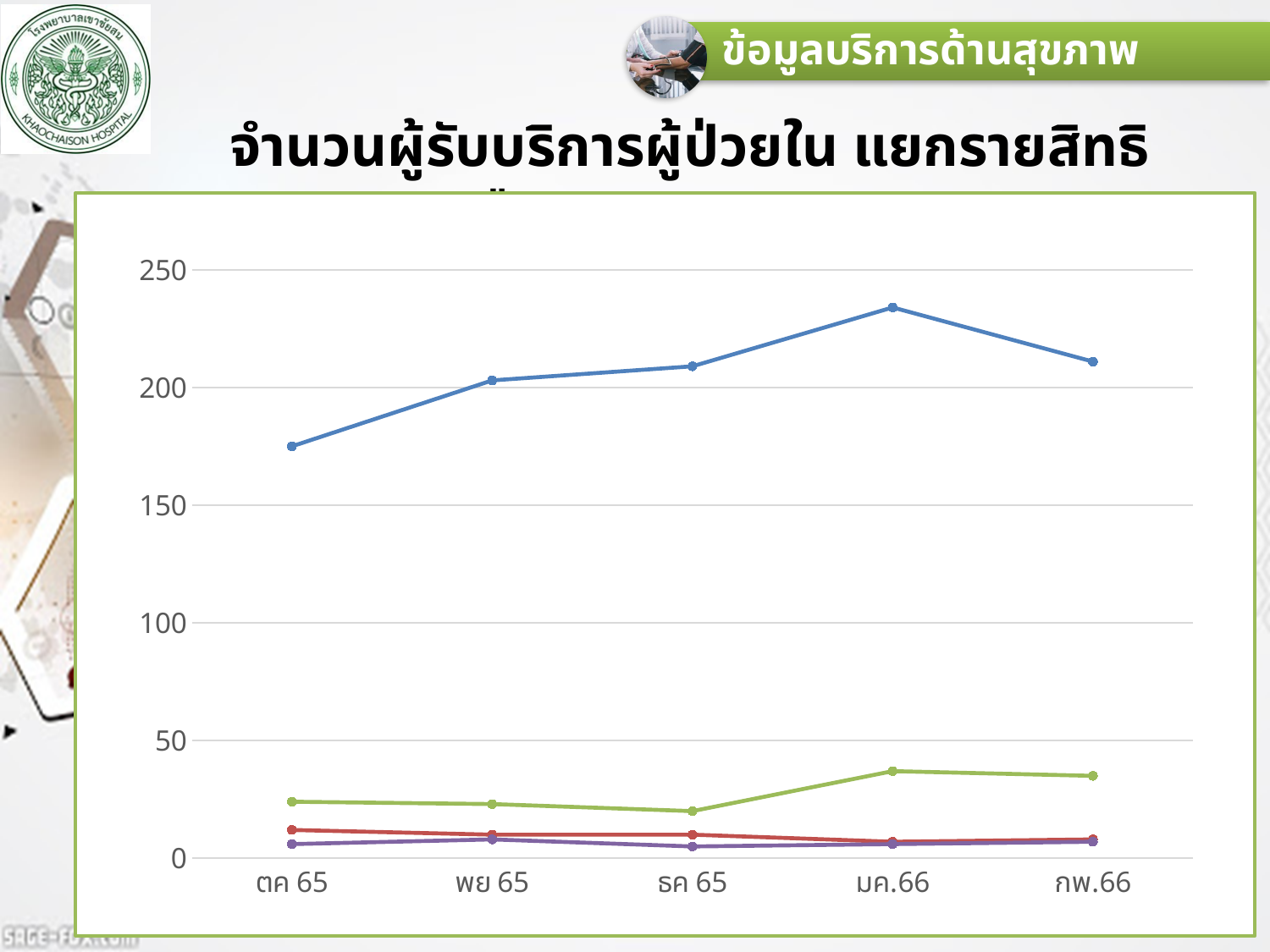
How many categories are shown on the x axis of the chart? 5 Is the value of the blue line at มค.66 greater or less than 200? greater Is the value of the green line at มค.66 greater or less than 50? less Which line on the chart has the highest values across all categories? the blue line Which is larger for the blue line: the value at มค.66 or the value at ตค 65? มค.66 How many lines are plotted on the chart? 4 What kind of chart is shown on the slide? line chart At which category does the blue line have its lowest value? ตค 65 At which category does the blue line reach its highest value? มค.66 Which is larger for the green line: the value at มค.66 or the value at ธค 65? มค.66 Is the value of the blue line at ตค 65 greater or less than 200? less Does the blue line rise or fall from ตค 65 to มค.66? rise